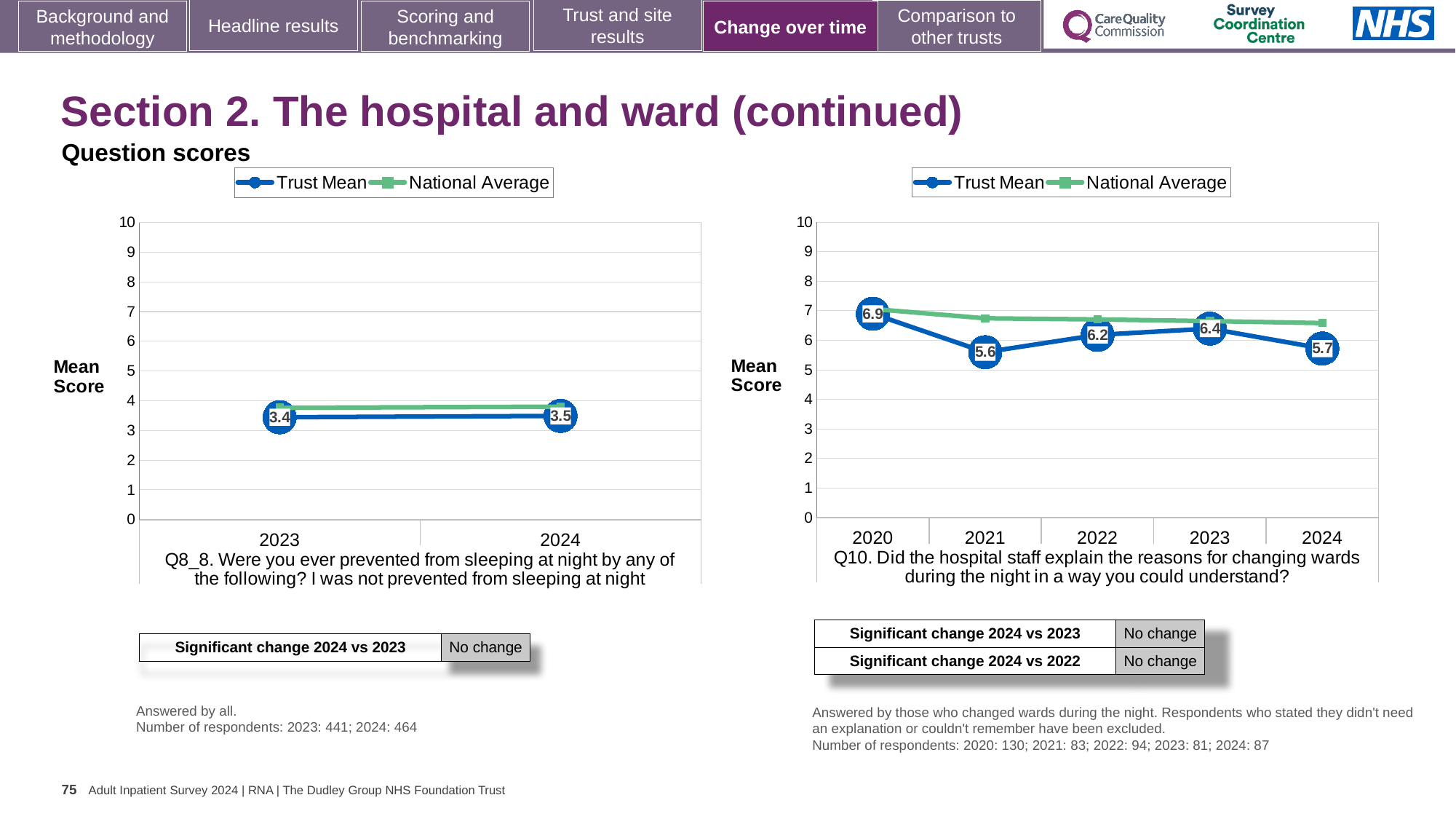
In the right chart (Q10), what is the Trust Mean score for 2021? 5.6 In the right chart (Q10), is the National Average for 2020 greater or less than 6? greater In the left chart (Q8_8), what is the Trust Mean score for 2024? 3.5 In the right chart (Q10), what is the Trust Mean score for 2024? 5.7 What type of chart is used for Q10 on the right of the slide? Line chart In the right chart (Q10), is the Trust Mean score for 2023 higher or lower than for 2022? higher How many years are plotted on the x axis of the right chart (Q10)? 5 In the left chart (Q8_8), what is the Trust Mean score for 2023? 3.4 In the right chart (Q10), which year has the lowest Trust Mean score? 2021 In the right chart (Q10), which year has the highest Trust Mean score? 2020 How many series does the legend of the left chart (Q8_8) list? 2 In the right chart (Q10), what is the difference between the Trust Mean scores for 2020 and 2021? 1.3